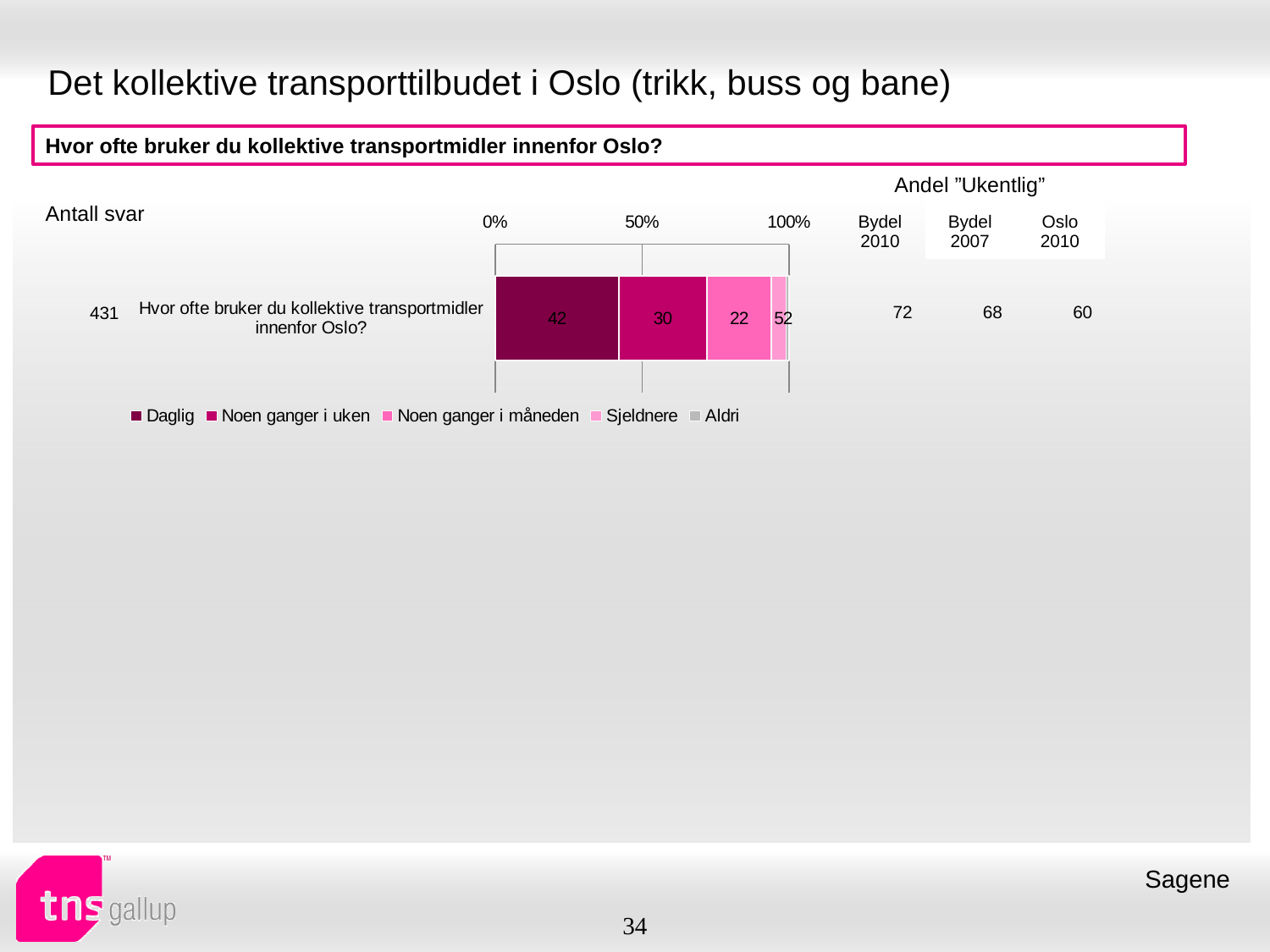
How many series does the legend list? 5 What is the value for "Noen ganger i uken" in the stacked bar? 30 What is the value for "Noen ganger i måneden" in the stacked bar? 22 What is the last entry listed in the chart legend? Aldri What is the value for "Daglig" in the bar for "Hvor ofte bruker du kollektive transportmidler innenfor Oslo?"? 42 Which is larger, the "Daglig" segment or the "Noen ganger i måneden" segment? Daglig How many bars (categories) are plotted in the chart? 1 Is the "Daglig" segment greater or less than 50%? less What kind of chart is shown on the slide? Stacked bar chart What is the difference between the "Daglig" value and the "Noen ganger i uken" value? 12 What is the number of responses (Antall svar) shown for the chart's question? 431 Which series has the largest segment in the stacked bar? Daglig